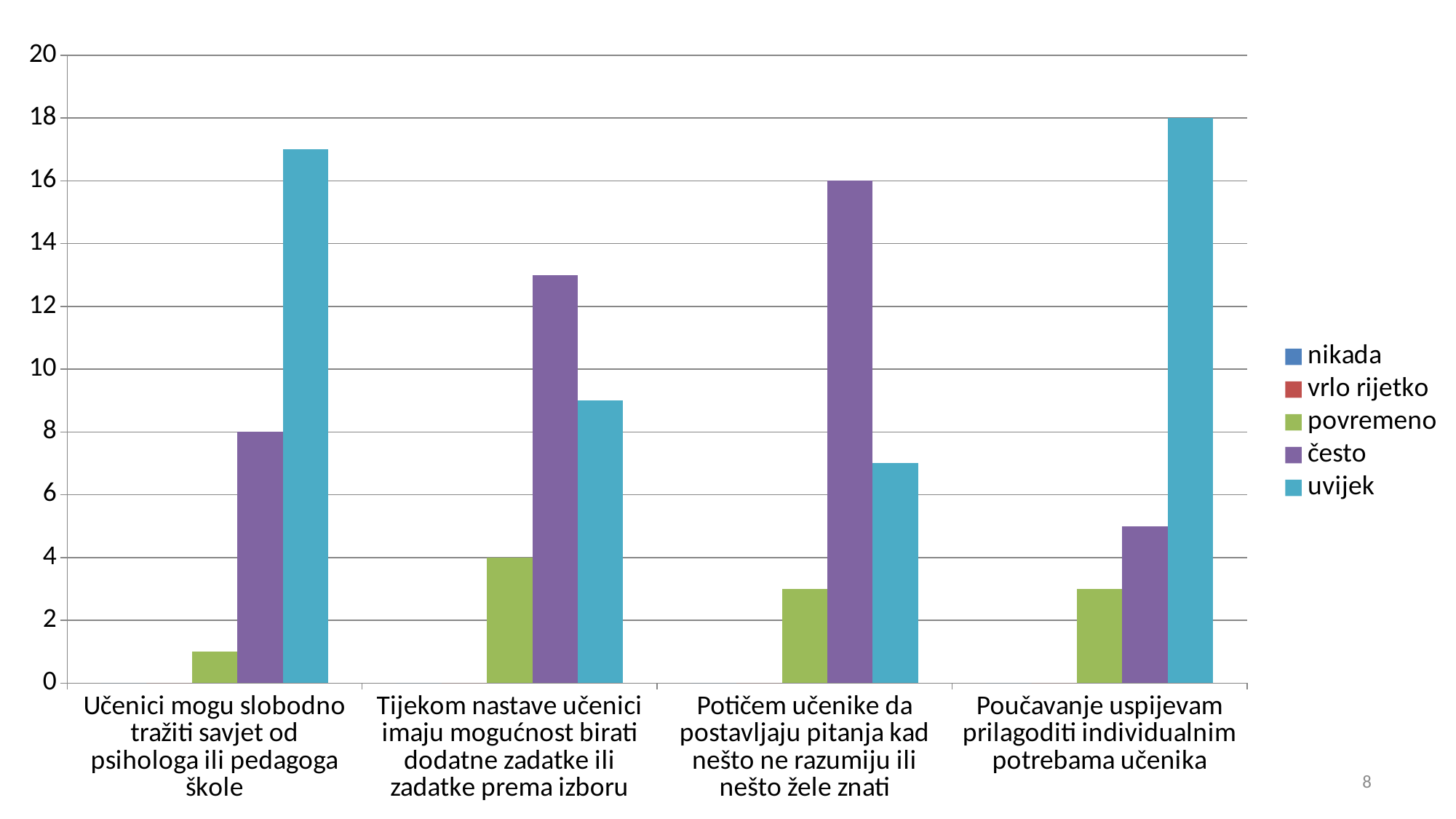
Which legend entry is shown in purple? često What kind of chart is shown on the slide? bar chart Is the value of 'uvijek' for 'Učenici mogu slobodno tražiti savjet od psihologa ili pedagoga škole' greater or less than 16? greater How many series does the legend list? 5 For 'Potičem učenike da postavljaju pitanja kad nešto ne razumiju ili nešto žele znati', which is larger: 'često' or 'uvijek'? često How many categories are shown on the x axis? 4 What is the value of 'povremeno' for 'Tijekom nastave učenici imaju mogućnost birati dodatne zadatke ili zadatke prema izboru'? 4 Which category has the highest 'uvijek' value? Poučavanje uspijevam prilagoditi individualnim potrebama učenika What is the value of 'često' for 'Potičem učenike da postavljaju pitanja kad nešto ne razumiju ili nešto žele znati'? 16 What is the value of 'uvijek' for 'Poučavanje uspijevam prilagoditi individualnim potrebama učenika'? 18 What is the value of 'često' for 'Učenici mogu slobodno tražiti savjet od psihologa ili pedagoga škole'? 8 Is the value of 'često' for 'Tijekom nastave učenici imaju mogućnost birati dodatne zadatke ili zadatke prema izboru' greater or less than 12? greater